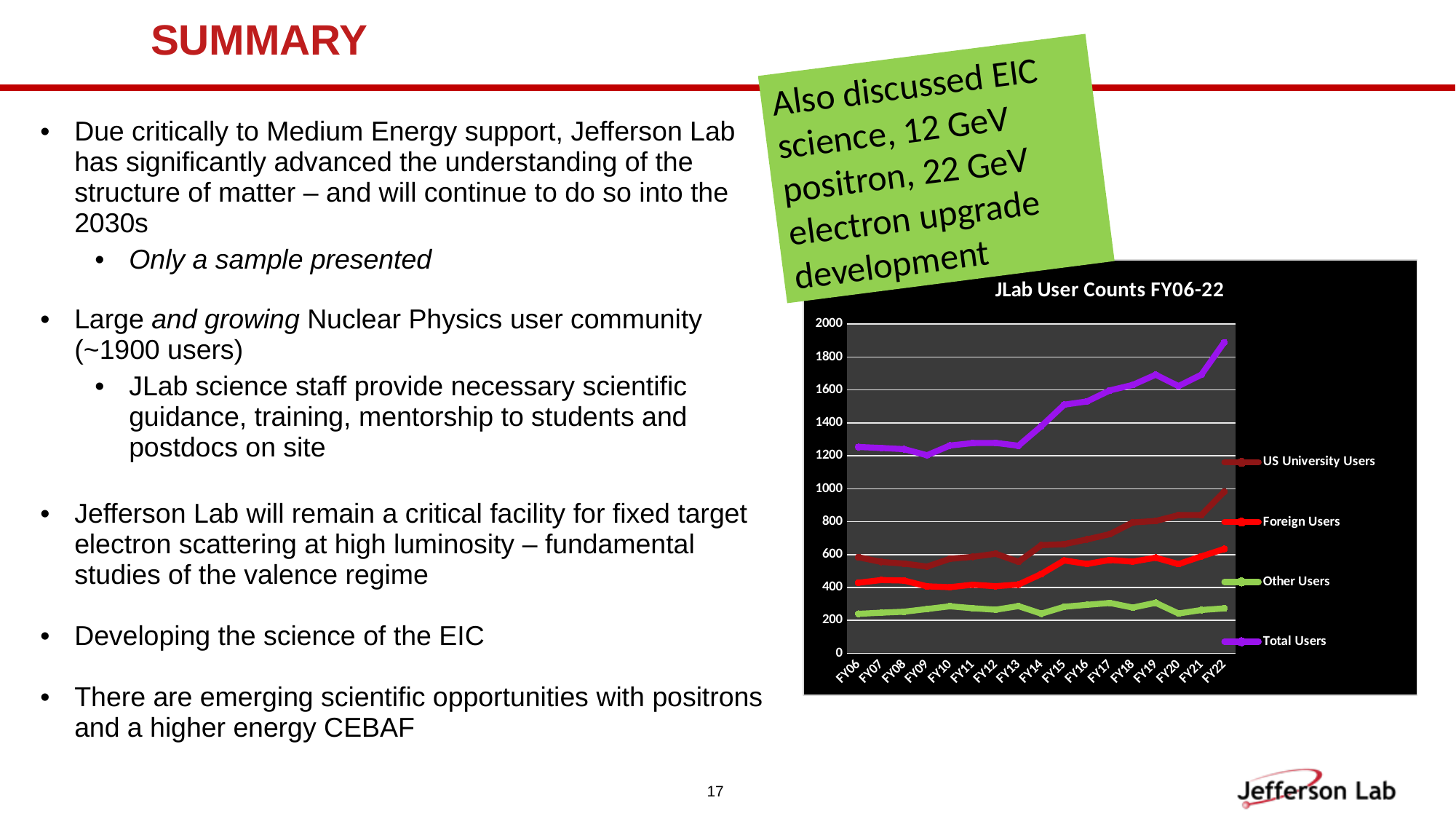
What kind of chart is shown on the slide? line chart In FY22, which is larger: Foreign Users or Other Users? Foreign Users How many series does the chart's legend list? 4 What is the title of the chart on the slide? JLab User Counts FY06-22 How many fiscal years are plotted along the x axis of the chart? 17 In which fiscal year do Total Users reach their highest value? FY22 Do Total Users generally rise or fall from FY06 to FY22? rise Is the value for Total Users in FY22 greater or less than 1800? greater Which series has the lowest values throughout the chart? Other Users Which series has the highest values throughout the chart? Total Users Is the value for US University Users in FY22 greater or less than 800? greater Is the value for Other Users in FY22 greater or less than 400? less